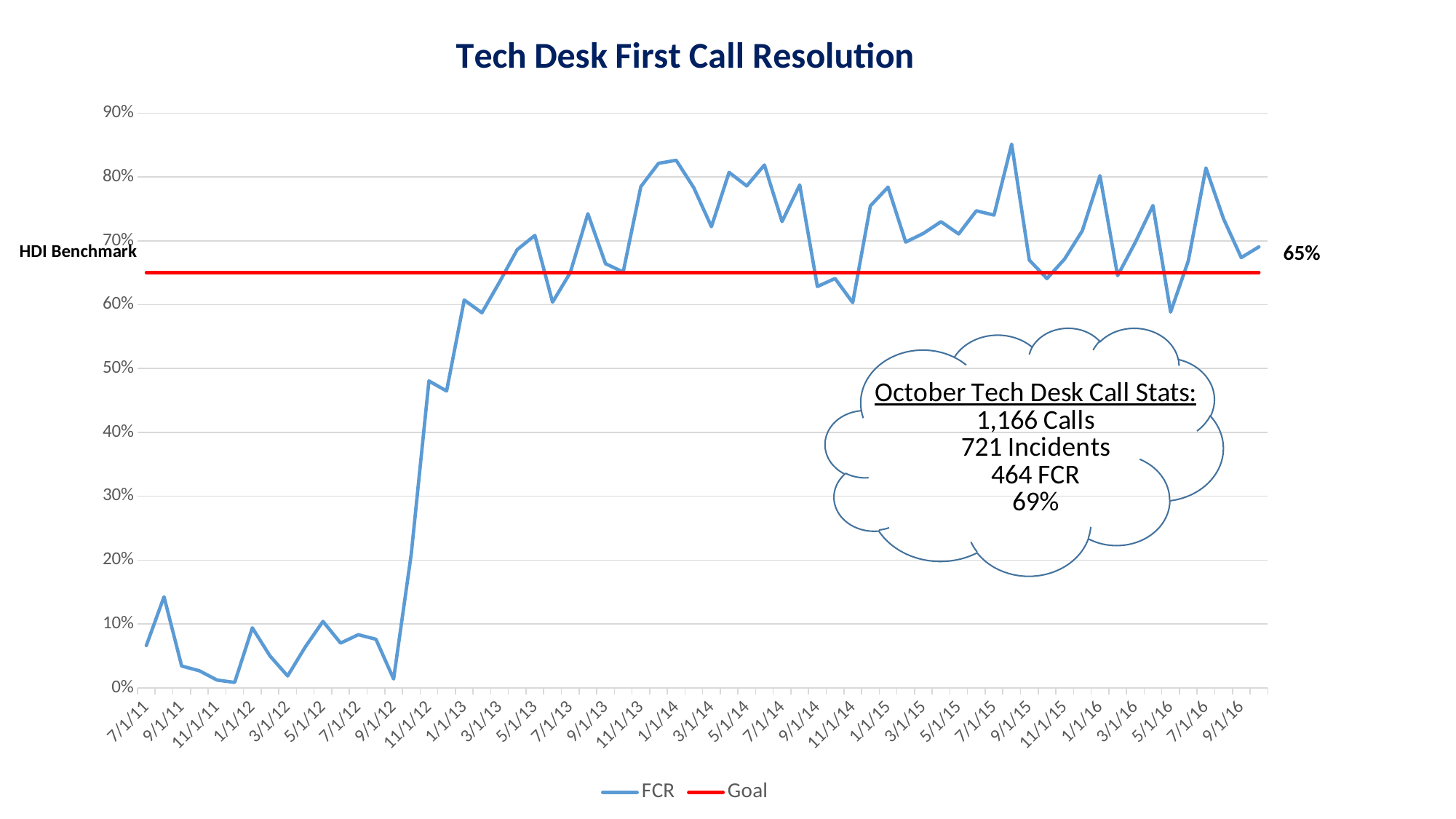
Which is larger, the FCR value for 1/1/12 or the FCR value for 1/1/14? 1/1/14 What kind of chart is shown on the slide? Line chart Which is larger, the FCR value for 7/1/11 or the FCR value for 7/1/13? 7/1/13 Is the FCR value for 9/1/12 greater or less than 10%? less What is the title of the chart? Tech Desk First Call Resolution How many series does the legend list? 2 What are the two series named in the legend? FCR and Goal What value is the Goal (HDI Benchmark) line set at? 65% Does the FCR line rise or fall between 9/1/12 and 11/1/12? rise Is the FCR value for 11/1/14 greater or less than 70%? less Is the FCR value for 1/1/14 greater or less than 70%? greater